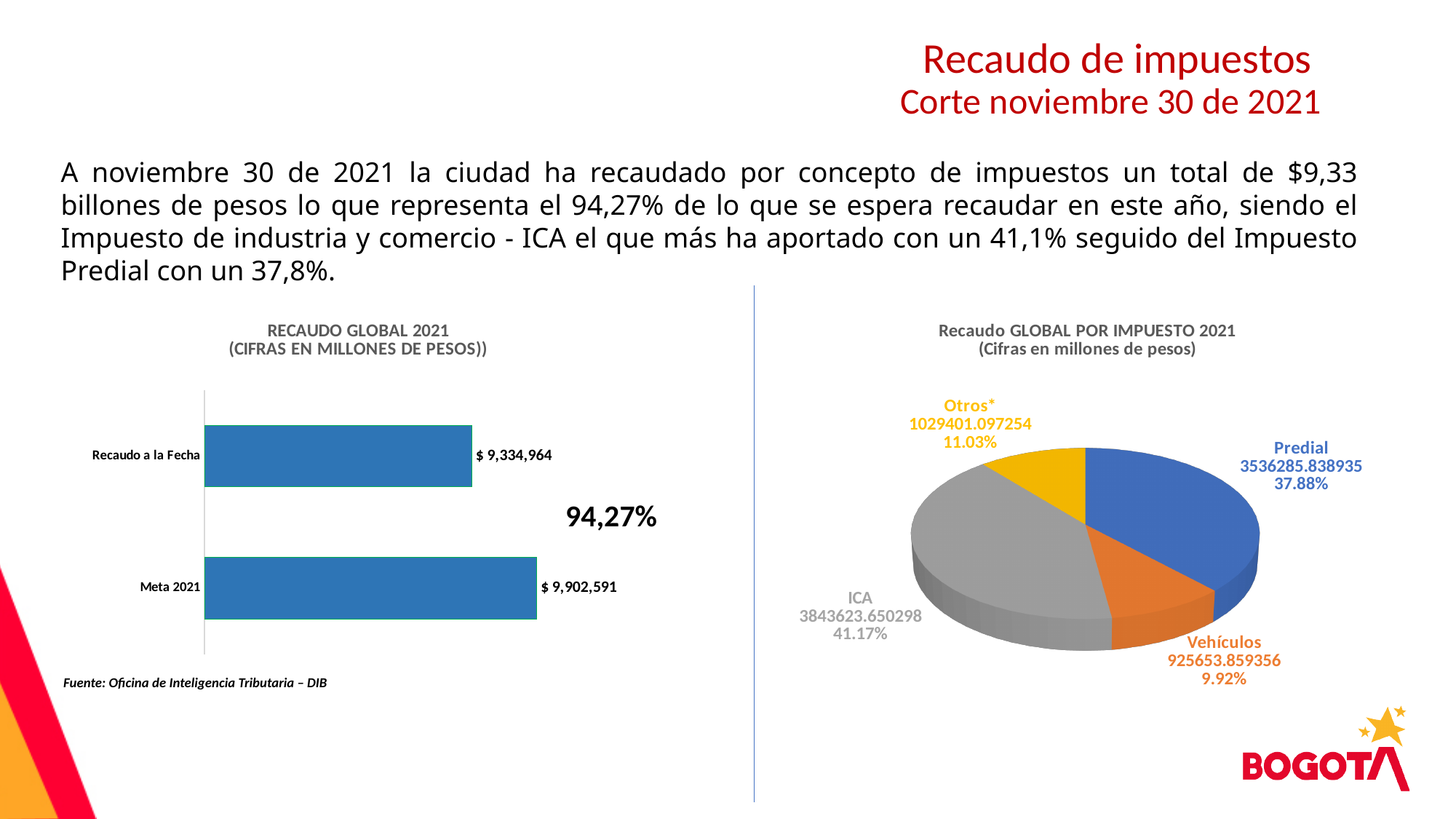
In the Recaudo GLOBAL POR IMPUESTO 2021 pie chart, what share does ICA represent? 41.17% In the Recaudo GLOBAL POR IMPUESTO 2021 pie chart, which tax has the largest slice? ICA What kind of chart is the RECAUDO GLOBAL 2021 chart on the left? Bar chart In the Recaudo GLOBAL POR IMPUESTO 2021 pie chart, what share does Otros* represent? 11.03% In the Recaudo GLOBAL POR IMPUESTO 2021 pie chart, what is the value for Predial? 3536285.838935 In the RECAUDO GLOBAL 2021 chart, what is the difference between Meta 2021 and Recaudo a la Fecha? $ 567,627 In the RECAUDO GLOBAL 2021 chart, what is the value for Meta 2021? $ 9,902,591 How many slices does the Recaudo GLOBAL POR IMPUESTO 2021 pie chart have? 4 In the RECAUDO GLOBAL 2021 chart, which category has the larger value, Recaudo a la Fecha or Meta 2021? Meta 2021 How many categories does the RECAUDO GLOBAL 2021 bar chart show? 2 In the RECAUDO GLOBAL 2021 chart, what is the value for Recaudo a la Fecha? $ 9,334,964 In the Recaudo GLOBAL POR IMPUESTO 2021 pie chart, which tax has the smallest slice? Vehículos